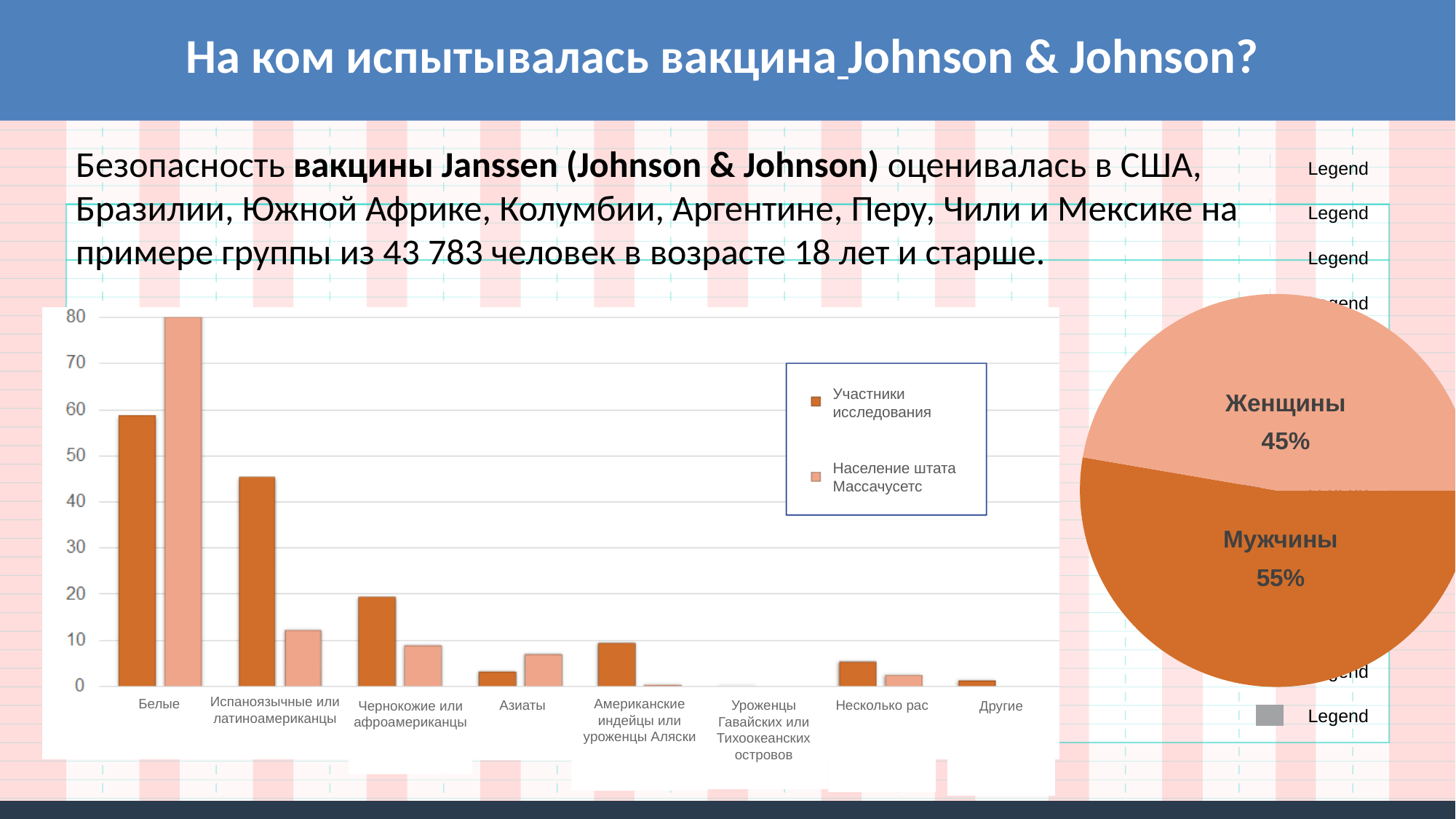
What kind of chart is the chart on the left of the slide? bar chart In the pie chart on the right, what share is shown for Женщины? 45% In the bar chart on the left, is the value for Испаноязычные или латиноамериканцы in the Население штата Массачусетс series greater or less than 20? less In the pie chart on the right, what is the difference between the shares for Мужчины and Женщины? 10% In the bar chart on the left, how many series does the legend list? 2 In the bar chart on the left, which category has the highest value for Участники исследования? Белые In the bar chart on the left, which is larger for Чернокожие или афроамериканцы: Участники исследования or Население штата Массачусетс? Участники исследования In the bar chart on the left, is the value for Белые in the Участники исследования series greater or less than 50? greater In the bar chart on the left, how many categories are shown on the x axis? 8 What kind of chart is the chart on the right of the slide? pie chart In the bar chart on the left, which is larger for Азиаты: Участники исследования or Население штата Массачусетс? Население штата Массачусетс In the pie chart on the right, what share is shown for Мужчины? 55%